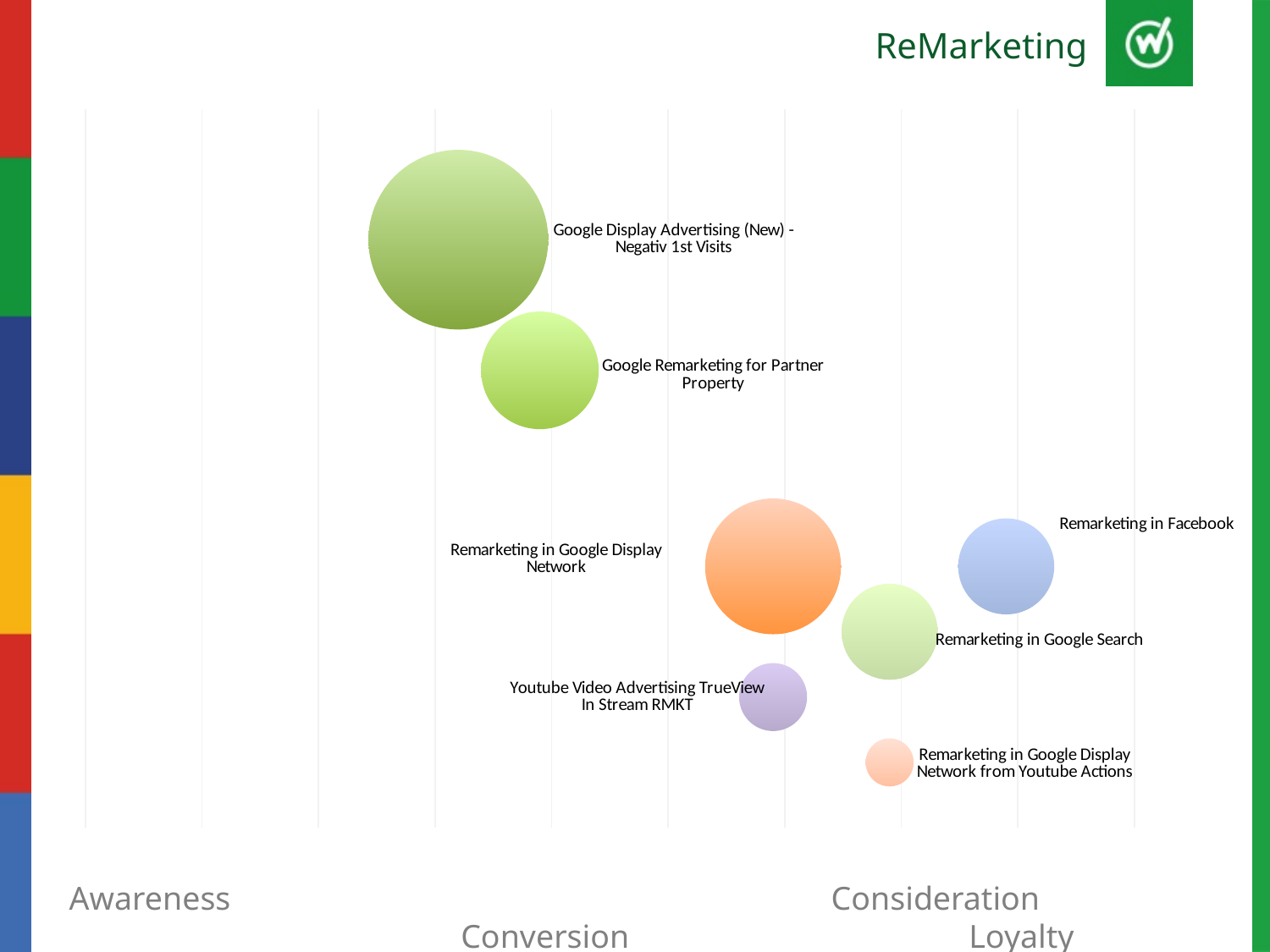
What colour is the Remarketing in Facebook bubble? Blue What is the title shown at the top of the slide? ReMarketing Which bubble is positioned furthest to the left on the chart? Google Display Advertising (New) - Negativ 1st Visits Which bubble is positioned lowest on the chart? Remarketing in Google Display Network from Youtube Actions Which bubble is larger, Remarketing in Google Display Network or Remarketing in Google Search? Remarketing in Google Display Network How many bubbles are plotted on the chart? 7 Which bubble is positioned furthest to the right on the chart? Remarketing in Facebook Which bubble is the largest on the chart? Google Display Advertising (New) - Negativ 1st Visits What kind of chart is shown on the slide? Bubble chart Which bubble is the smallest on the chart? Remarketing in Google Display Network from Youtube Actions Which bubble is positioned highest on the chart? Google Display Advertising (New) - Negativ 1st Visits Which bubble is larger, Remarketing in Facebook or Youtube Video Advertising TrueView In Stream RMKT? Remarketing in Facebook